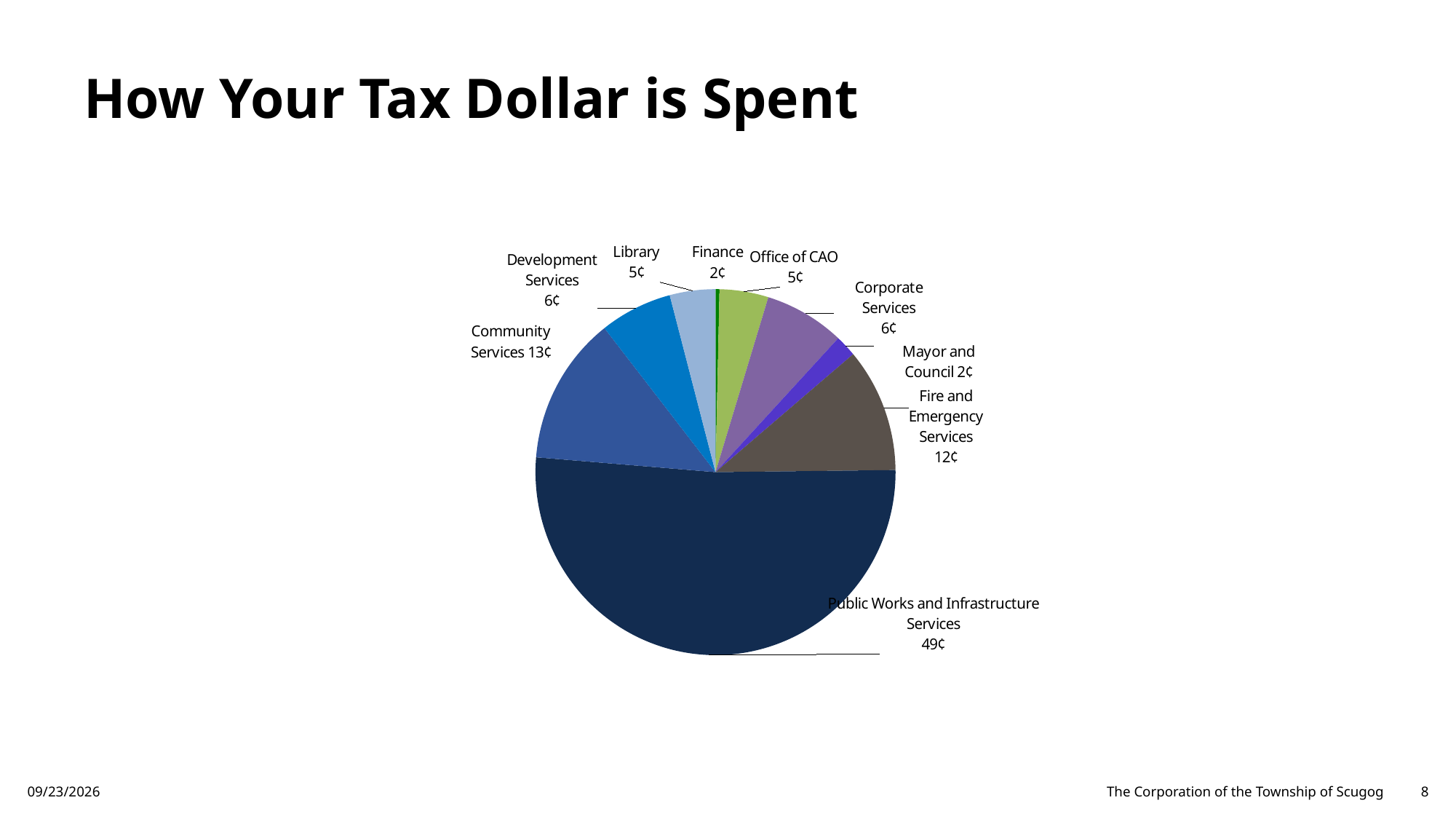
How many slices does the pie chart have? 9 How much of the tax dollar goes to Library? 5¢ How much of the tax dollar goes to Community Services? 13¢ How much of the tax dollar goes to Fire and Emergency Services? 12¢ What is the combined share of Development Services and Corporate Services? 12¢ Which category receives more of the tax dollar, Community Services or Fire and Emergency Services? Community Services What kind of chart is shown on the slide? Pie chart What is the title of the chart on the slide? How Your Tax Dollar is Spent Which category receives the largest share of the tax dollar? Public Works and Infrastructure Services Which two categories each receive 2¢ of the tax dollar? Finance and Mayor and Council How much of the tax dollar goes to Public Works and Infrastructure Services? 49¢ What is the difference between the Public Works and Infrastructure Services share and the Community Services share? 36¢